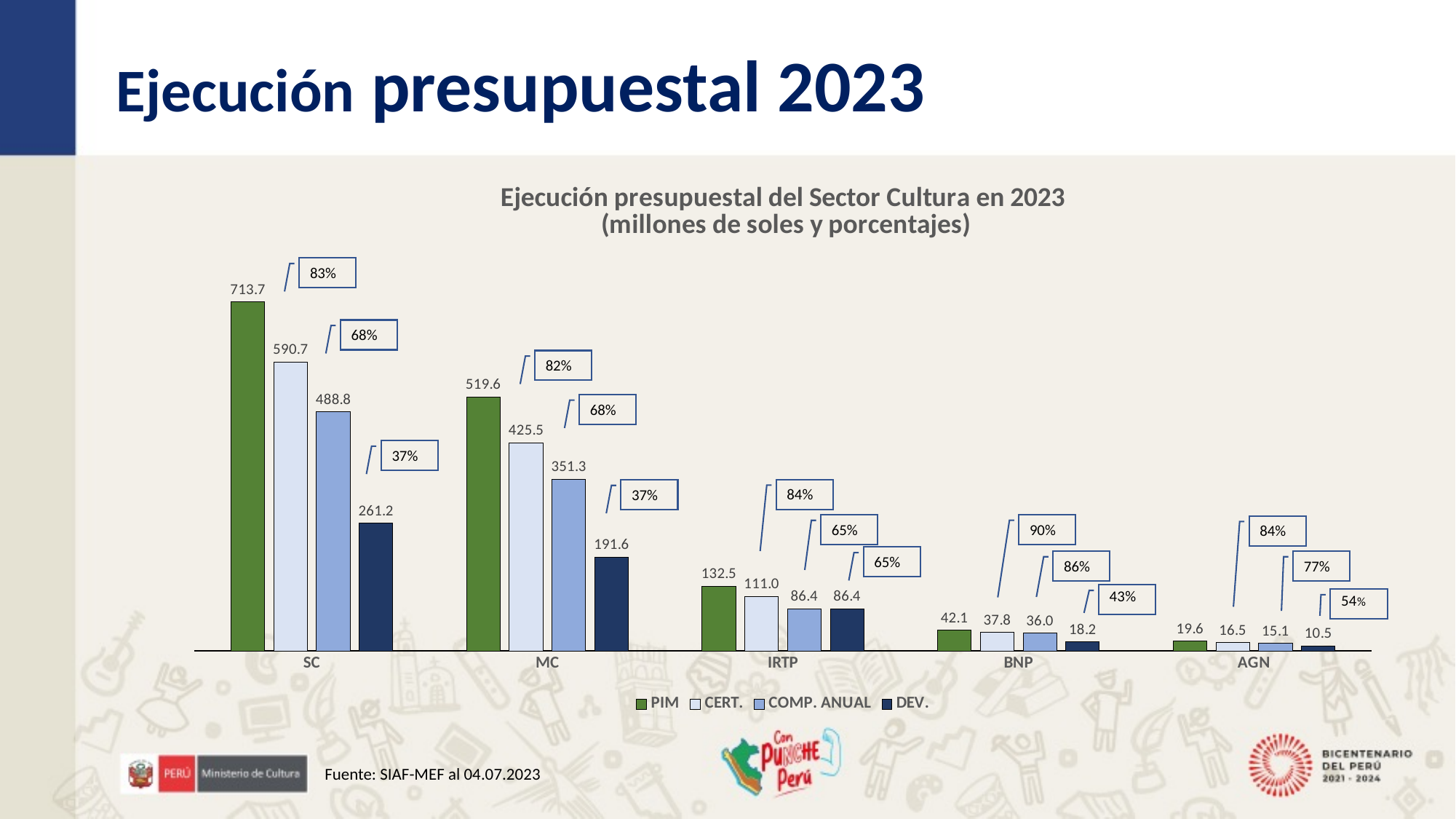
What is the difference between the PIM and DEV. values for SC? 452.5 Which category has the lowest DEV. value? AGN What is the PIM value for SC? 713.7 Which category has the highest PIM value? SC How many series does the legend list? 4 Which is larger, the CERT. value for MC or the CERT. value for SC? CERT. value for SC What kind of chart is shown on the slide? Bar chart How many categories are shown on the x axis? 5 What is the title of the chart? Ejecución presupuestal del Sector Cultura en 2023 (millones de soles y porcentajes) What is the CERT. value for IRTP? 111.0 What is the COMP. ANUAL value for BNP? 36.0 What is the DEV. value for MC? 191.6